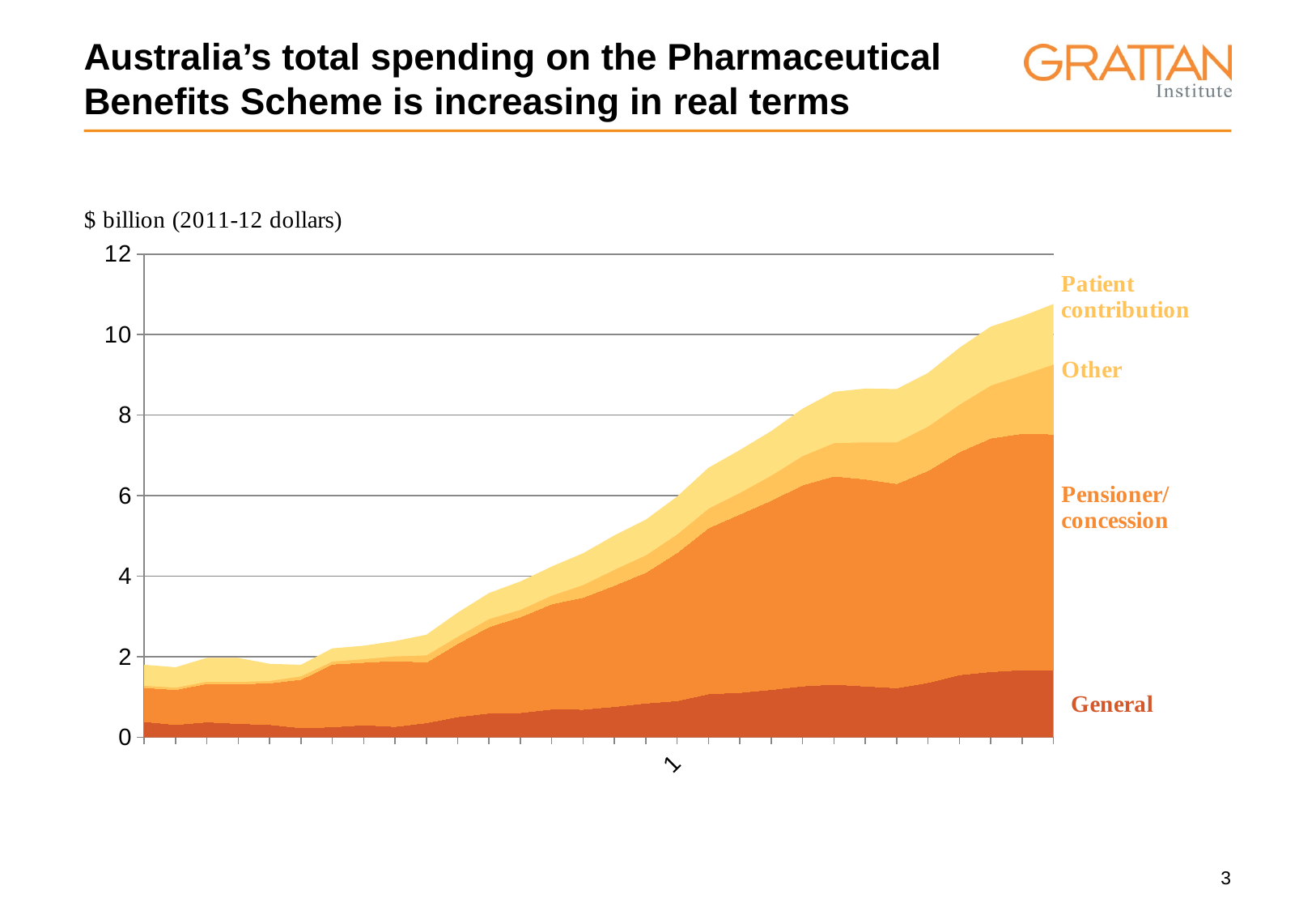
Is the total spending at the left-hand end of the chart greater or less than 2? less How many series are labelled on the chart? 4 Is the total spending at the right-hand end of the chart greater or less than 10? greater What kind of chart is shown on the slide? Stacked area chart What is the highest value shown on the y axis? 12 Is the General series at the right-hand end of the chart greater or less than 2? less Which series accounts for the largest share of spending at the right-hand end of the chart? Pensioner/concession What unit is shown on the y axis of the chart? $ billion (2011-12 dollars) At the right-hand end of the chart, which is larger: Pensioner/concession or General? Pensioner/concession Does total spending rise or fall from left to right along the x axis? Rise Does the General series rise or fall from left to right along the x axis? Rise What are the four series labelled on the chart? Patient contribution, Other, Pensioner/concession, General